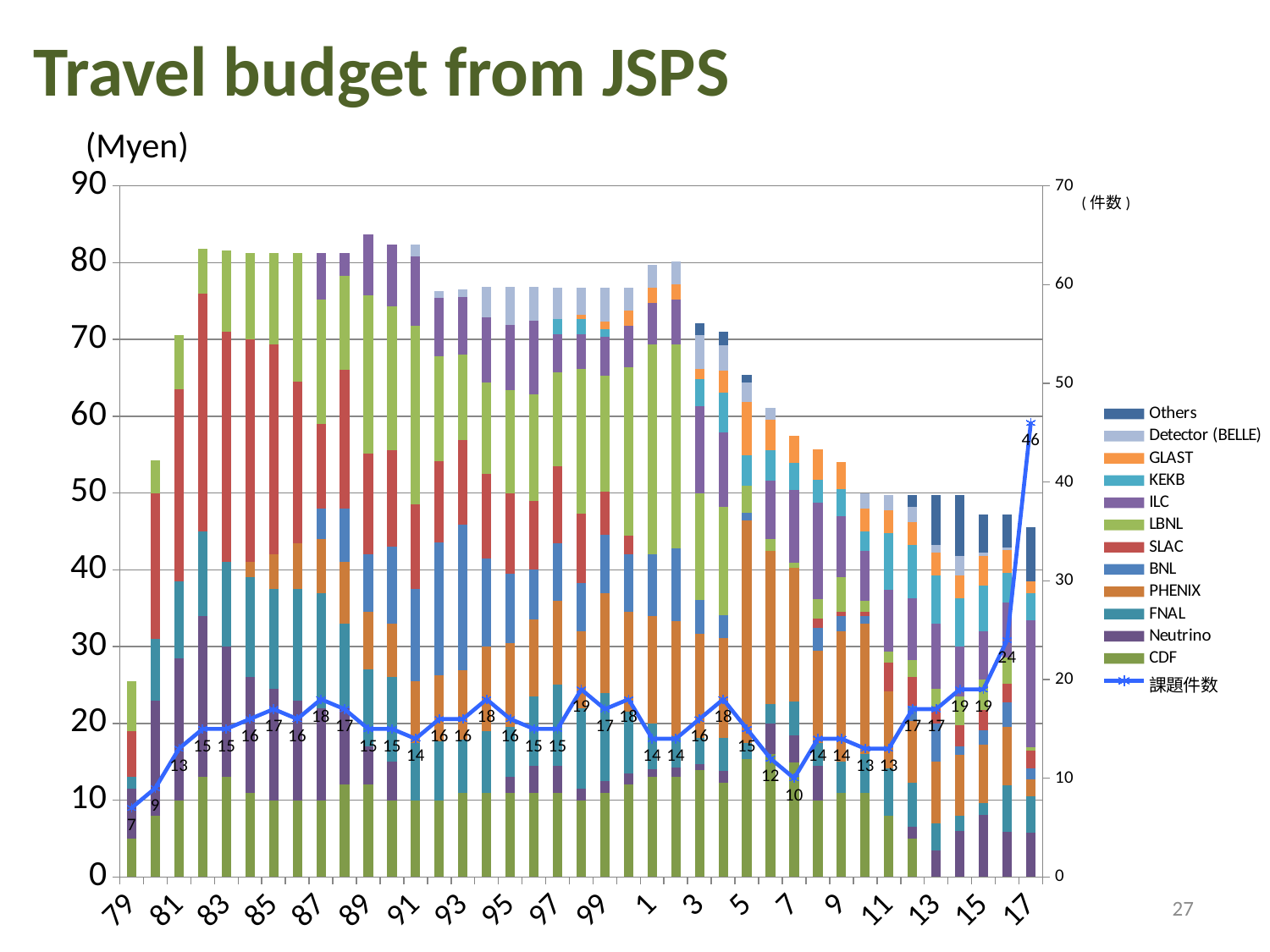
Does the 課題件数 line rise or fall from 11 to 17? rise What kind of chart is used to show the travel budget? Stacked bar chart (with a line series) What is the value of the 課題件数 line at 7? 10 In which year does the 課題件数 line have its lowest value? 79 What is the value of the 課題件数 line at 17? 46 What is the difference between the 課題件数 values at 17 and at 15? 27 Is the total stacked bar for 79 greater or less than 30 Myen? less Which is larger, the 課題件数 value at 87 or at 91? 87 What is the title of the chart? Travel budget from JSPS What is the value of the 課題件数 line at 79? 7 How many entries does the legend list? 13 In which year does the 課題件数 line reach its highest value? 17